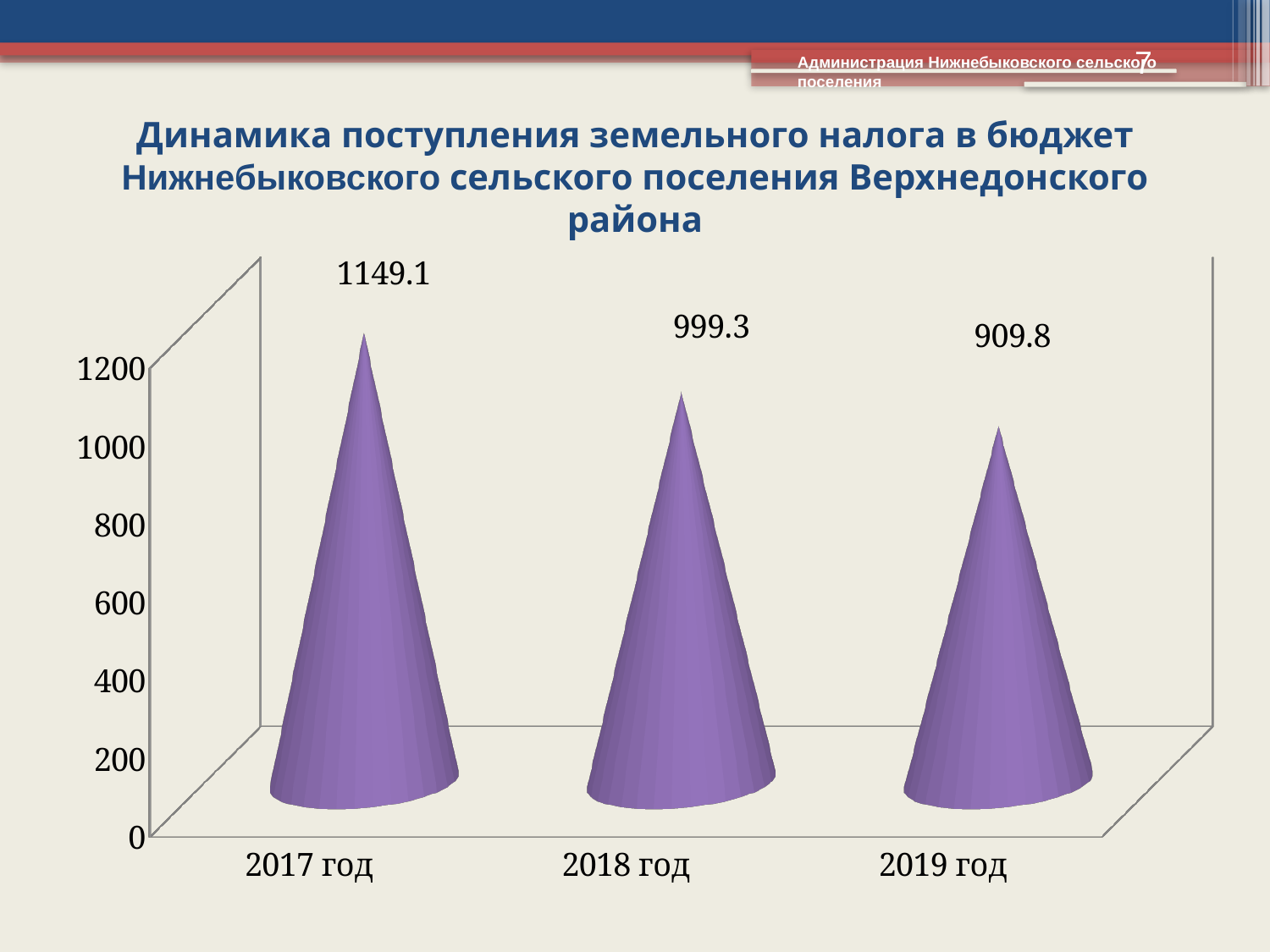
What kind of chart is shown on the slide? bar chart Which year has the lowest value? 2019 год What is the value for 2017 год? 1149.1 What is the difference between the values for 2018 год and 2019 год? 89.5 Is the value for 2019 год greater or less than 1000? less Which is larger, the value for 2017 год or the value for 2019 год? 2017 год What is the value for 2019 год? 909.8 What is the difference between the values for 2017 год and 2018 год? 149.8 What is the value for 2018 год? 999.3 Which year has the highest value? 2017 год Do the values rise or fall from 2017 год to 2019 год? fall How many years are shown on the chart? 3